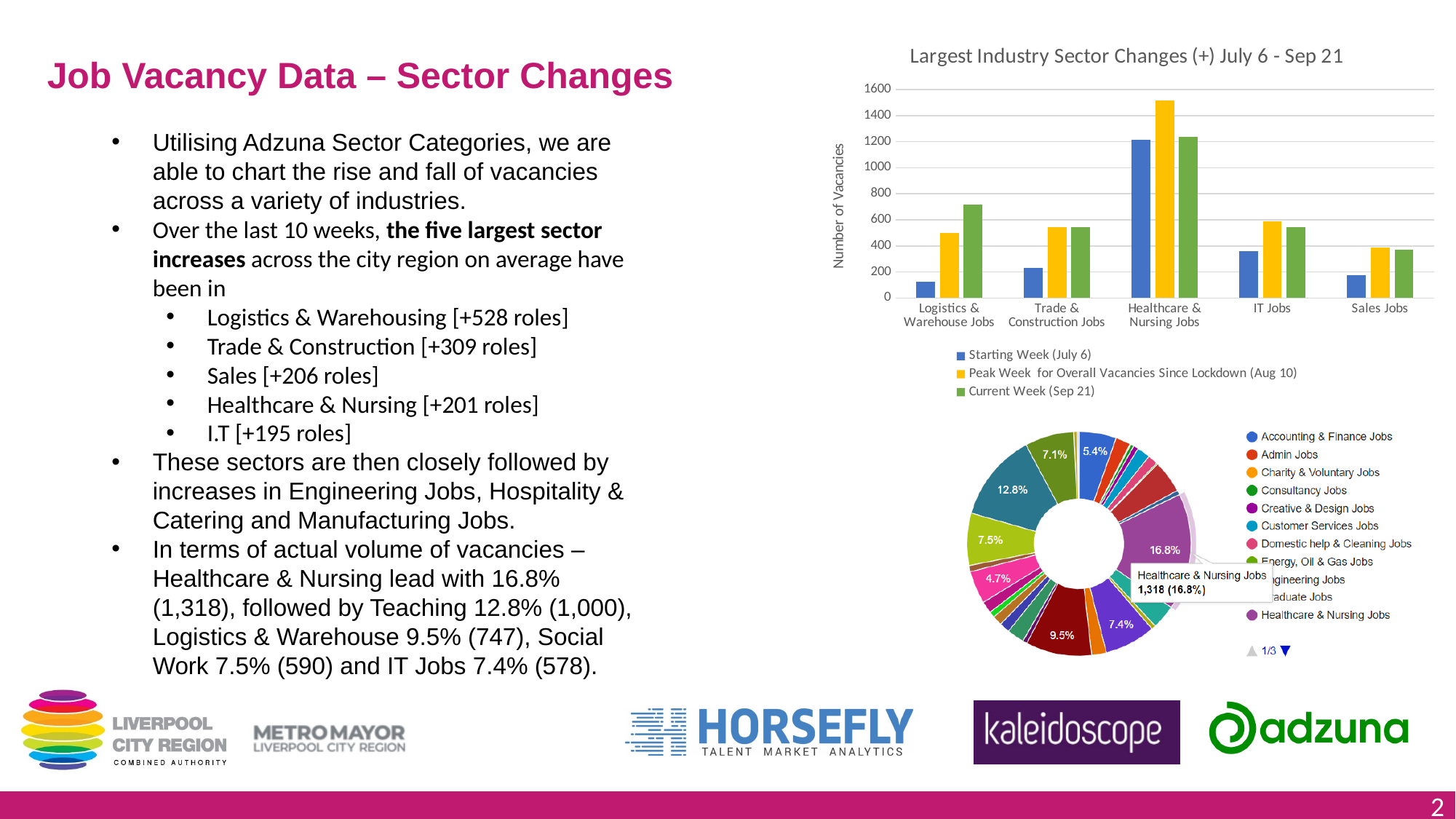
In the 'Largest Industry Sector Changes' bar chart, which is larger for the Starting Week (July 6): Healthcare & Nursing Jobs or IT Jobs? Healthcare & Nursing Jobs In the 'Largest Industry Sector Changes' bar chart, is the Peak Week (Aug 10) value for Healthcare & Nursing Jobs greater or less than 1400? greater How many job sector categories are shown on the x axis of the 'Largest Industry Sector Changes' bar chart? 5 In the donut chart at the bottom right, how many vacancies are shown for Healthcare & Nursing Jobs? 1,318 What type of chart is the top chart titled 'Largest Industry Sector Changes (+) July 6 - Sep 21'? Bar chart In the 'Largest Industry Sector Changes' bar chart, is the Starting Week (July 6) value for Logistics & Warehouse Jobs greater or less than 200? less In the 'Largest Industry Sector Changes' bar chart, which colour represents the Current Week (Sep 21) series? Green How many series does the legend of the 'Largest Industry Sector Changes' bar chart list? 3 In the donut chart at the bottom right, what share of vacancies do Healthcare & Nursing Jobs account for? 16.8% In the 'Largest Industry Sector Changes' bar chart, which sector has the highest Peak Week (Aug 10) value? Healthcare & Nursing Jobs In the 'Largest Industry Sector Changes' bar chart, is the Current Week (Sep 21) value for Logistics & Warehouse Jobs greater or less than 600? greater In the 'Largest Industry Sector Changes' bar chart, what is the label of the y axis? Number of Vacancies